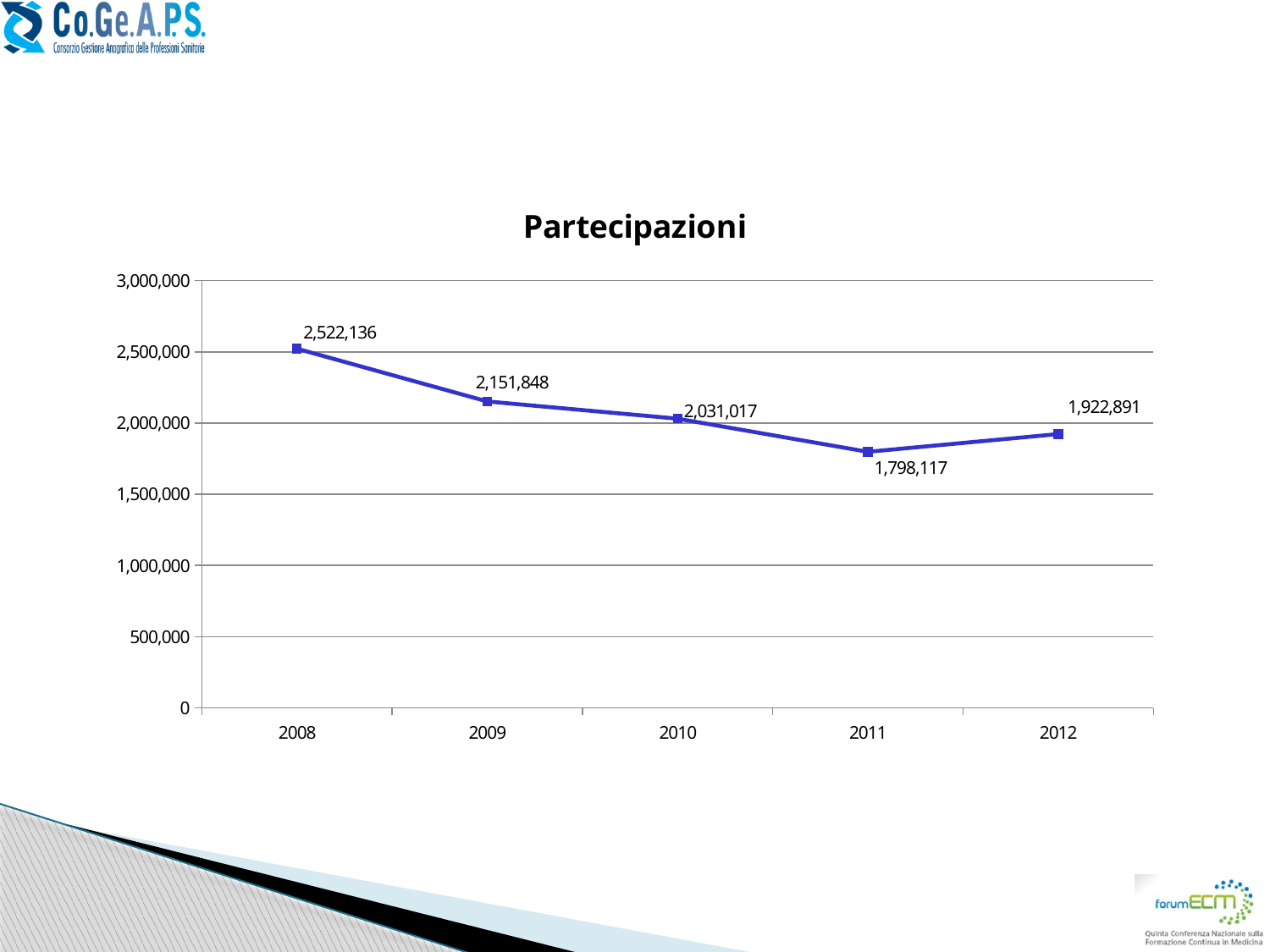
Is the value for 2011 in the Partecipazioni chart greater or less than 2,000,000? less Do the values in the Partecipazioni chart rise or fall from 2008 to 2011? fall What is the value for 2012 in the Partecipazioni chart? 1,922,891 How many years are plotted in the Partecipazioni chart? 5 What is the difference between the 2008 and 2009 values in the Partecipazioni chart? 370,288 Which is larger in the Partecipazioni chart, the value for 2010 or the value for 2012? 2010 What is the value for 2011 in the Partecipazioni chart? 1,798,117 What is the value for 2008 in the Partecipazioni chart? 2,522,136 Which year has the highest value in the Partecipazioni chart? 2008 Which year has the lowest value in the Partecipazioni chart? 2011 By how much did the value increase from 2011 to 2012 in the Partecipazioni chart? 124,774 What kind of chart is the Partecipazioni chart? line chart